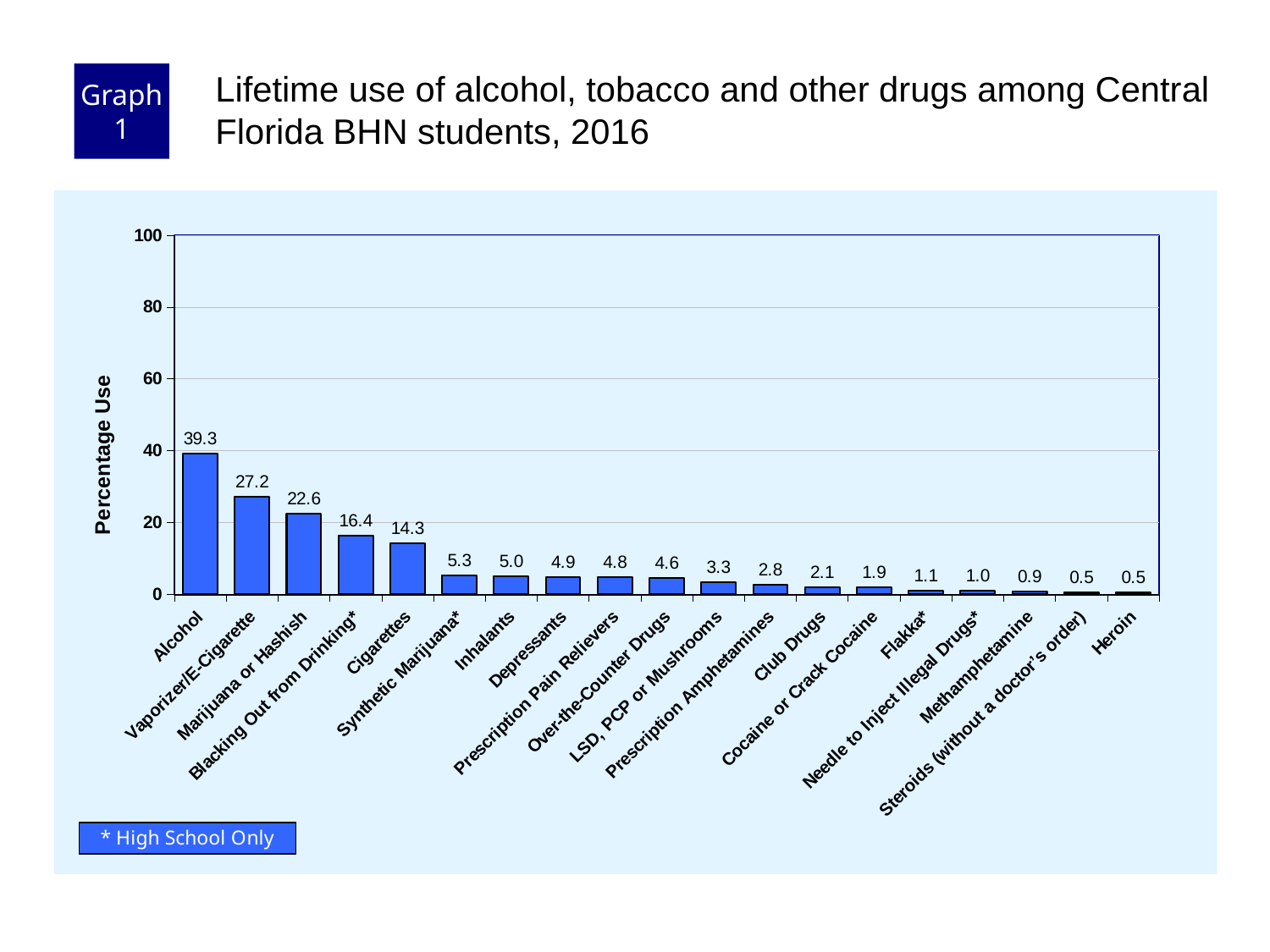
What is the percentage use for Cigarettes? 14.3 Do the values rise or fall from left to right along the x axis? fall Is the value for Blacking Out from Drinking* greater or less than 20? less What kind of chart is shown on the slide? bar chart What is the percentage use for Club Drugs? 2.1 How many categories are shown on the x axis? 19 What is the label of the y axis? Percentage Use What is the percentage use for Alcohol? 39.3 What is the difference in percentage use between Alcohol and Vaporizer/E-Cigarette? 12.1 Which category has the highest percentage use? Alcohol Which has a higher percentage use, Marijuana or Hashish or Cigarettes? Marijuana or Hashish What does the asterisk (*) after some category names indicate, according to the note on the slide? High School Only